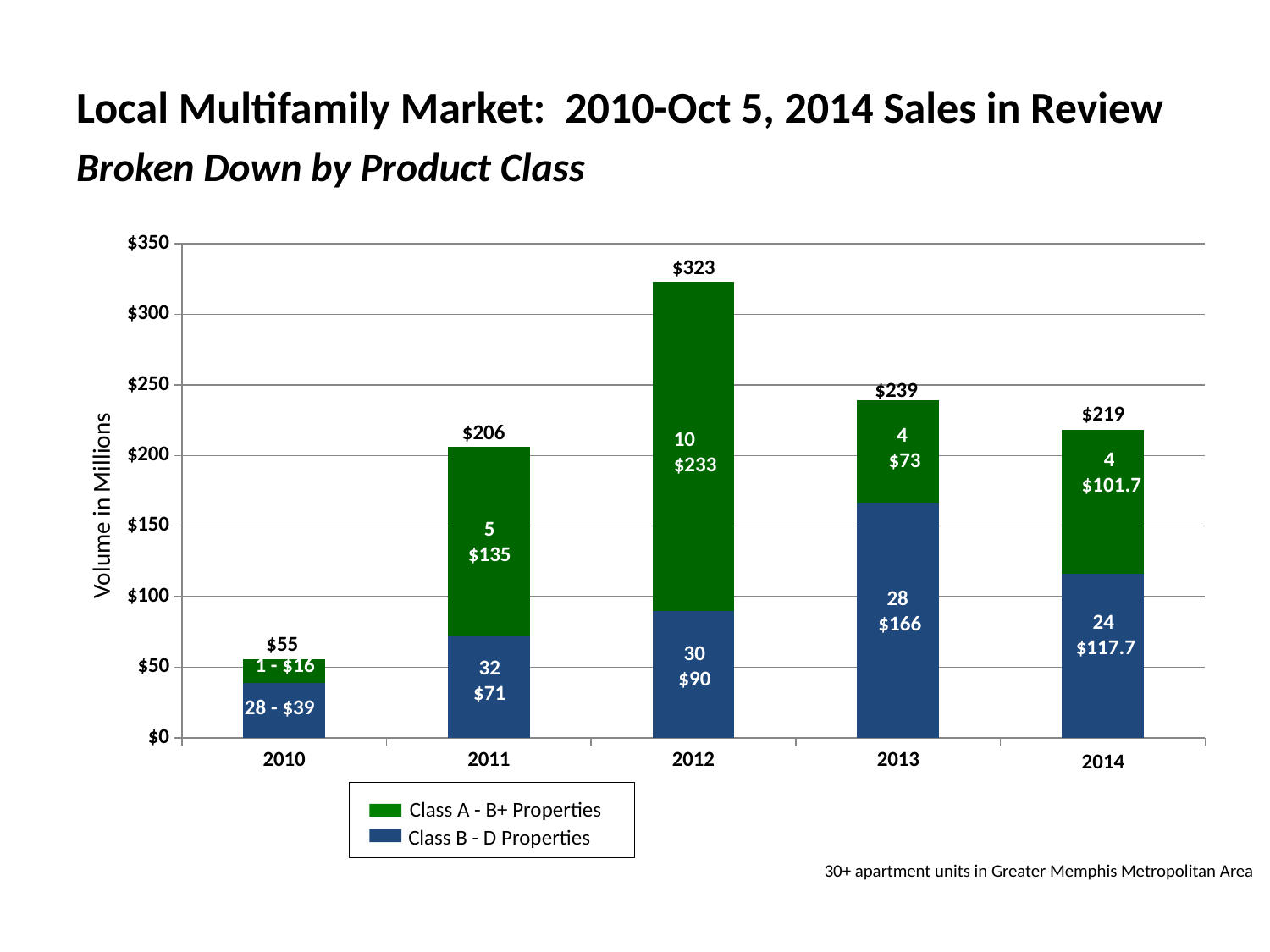
What kind of chart is shown on the slide? Stacked bar chart What is the total of the stacked bar for 2011? $206 What is the dollar value labeled for Class A - B+ Properties in 2014? $101.7 What is the difference between the total sales volume in 2012 and in 2013? $84 How many series does the legend list? 2 What is the total sales volume shown above the 2012 bar? $323 Which year has the highest total sales volume? 2012 What is the label of the y axis? Volume in Millions How many years are shown on the x axis? 5 Which is larger: the Class A - B+ Properties value in 2011 or the Class B - D Properties value in 2011? Class A - B+ Properties Which year has the lowest total sales volume? 2010 What is the dollar value labeled for Class B - D Properties in 2013? $166